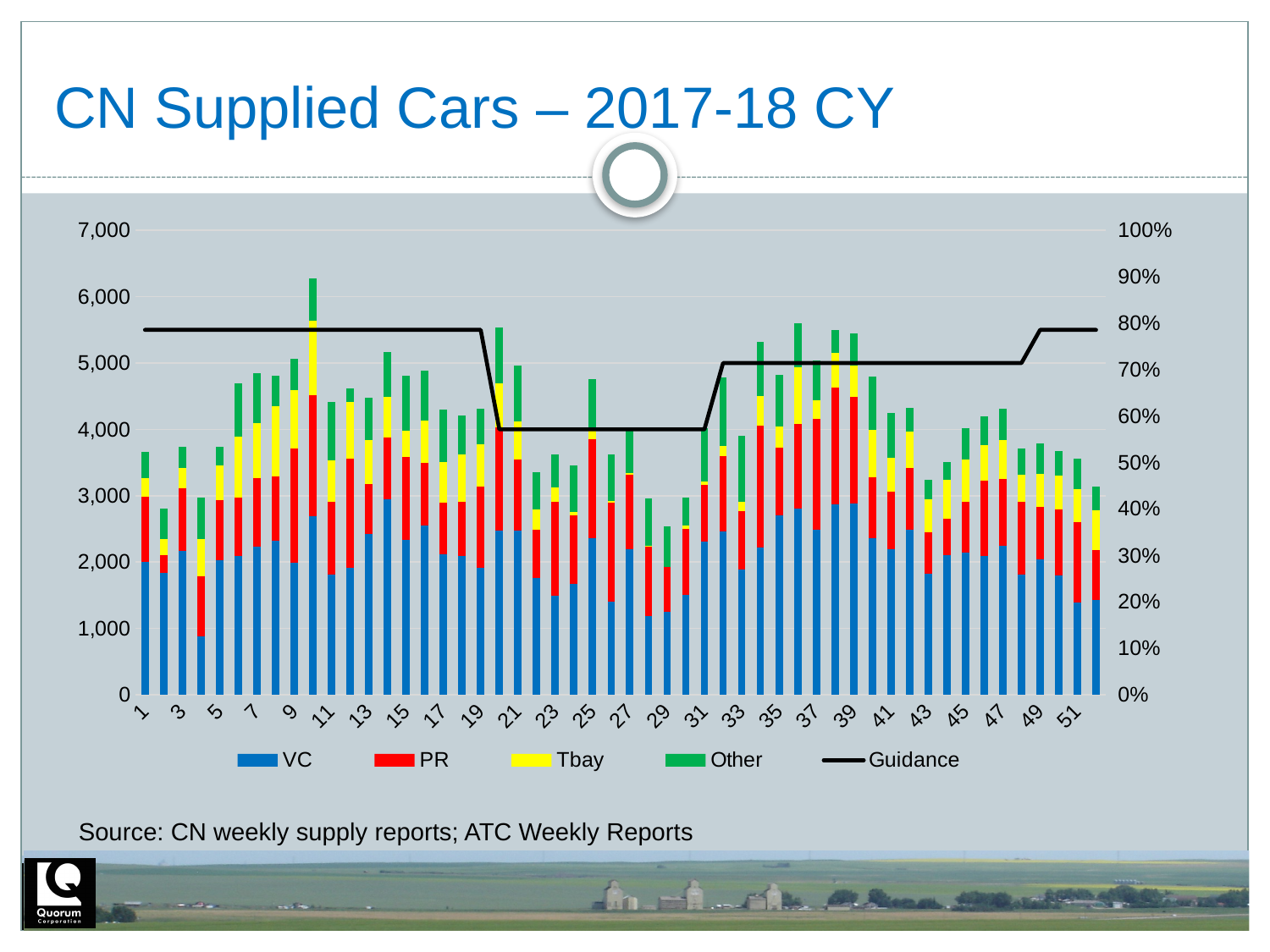
What is the title of the chart? CN Supplied Cars – 2017-18 CY How many series does the legend list? 5 Which week has the highest total stacked bar? 10 Is the total for week 10 greater or less than 6,000? greater Which is larger, the total for week 10 or the total for week 28? week 10 Does the Guidance line rise or fall between week 19 and week 21? fall Which series is plotted as a black line? Guidance What kind of chart is shown on the slide? bar chart (stacked) with a line